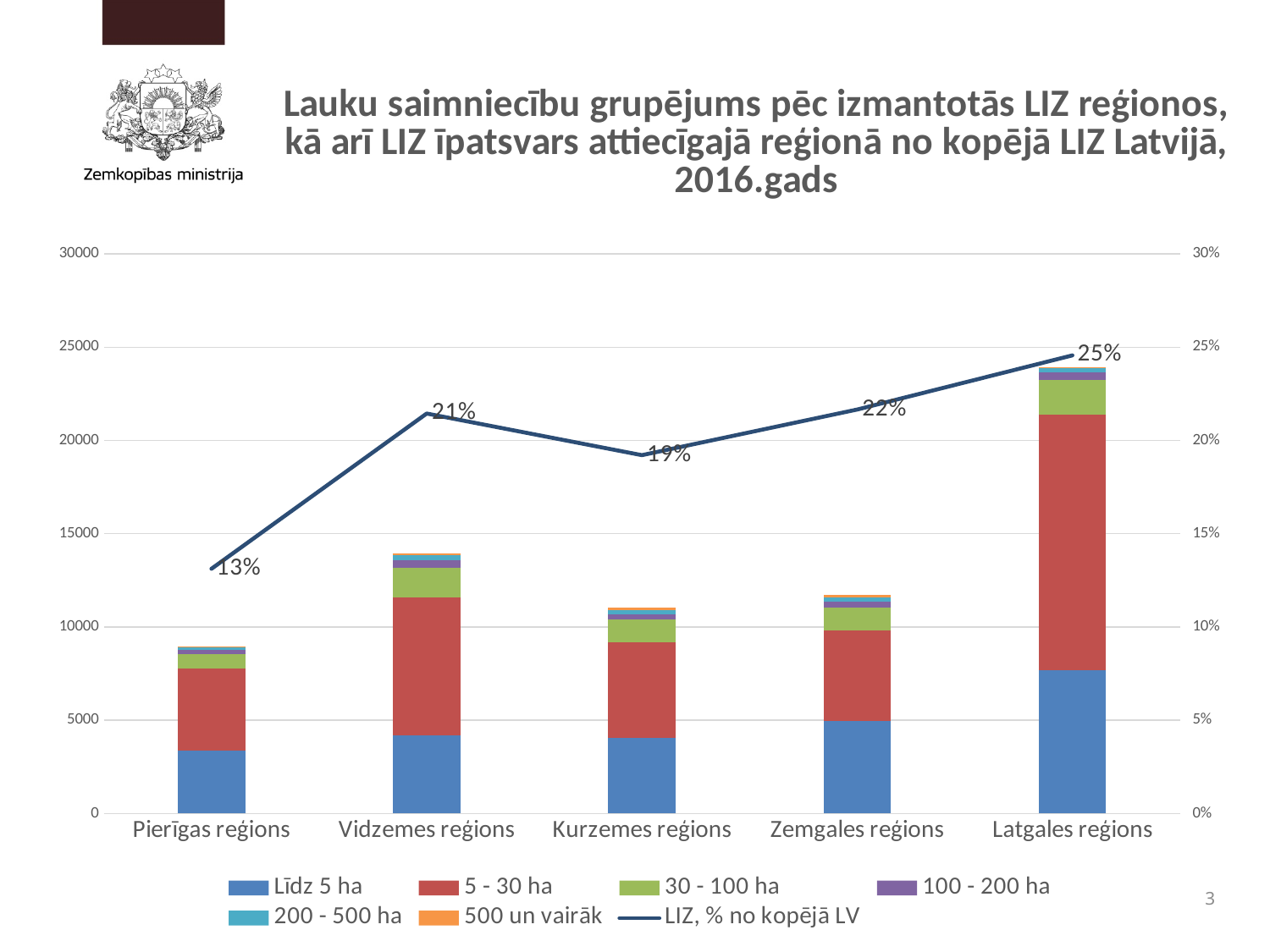
What is the difference between the line values for Latgales reģions and Pierīgas reģions? 12 percentage points Which region has the tallest stacked bar? Latgales reģions How many series does the legend list? 7 Is the total height of the stacked bar for Pierīgas reģions greater or less than 10000? less Which region has the lowest value on the line series 'LIZ, % no kopējā LV'? Pierīgas reģions Is the total height of the stacked bar for Latgales reģions greater or less than 20000? greater Which region has the highest value on the line series 'LIZ, % no kopējā LV'? Latgales reģions Which has a higher line value, Vidzemes reģions or Kurzemes reģions? Vidzemes reģions What is the value of the line series 'LIZ, % no kopējā LV' for Kurzemes reģions? 19% What is the value of the line series 'LIZ, % no kopējā LV' for Latgales reģions? 25% What is the value of the line series 'LIZ, % no kopējā LV' for Pierīgas reģions? 13% How many regions are shown on the x axis? 5